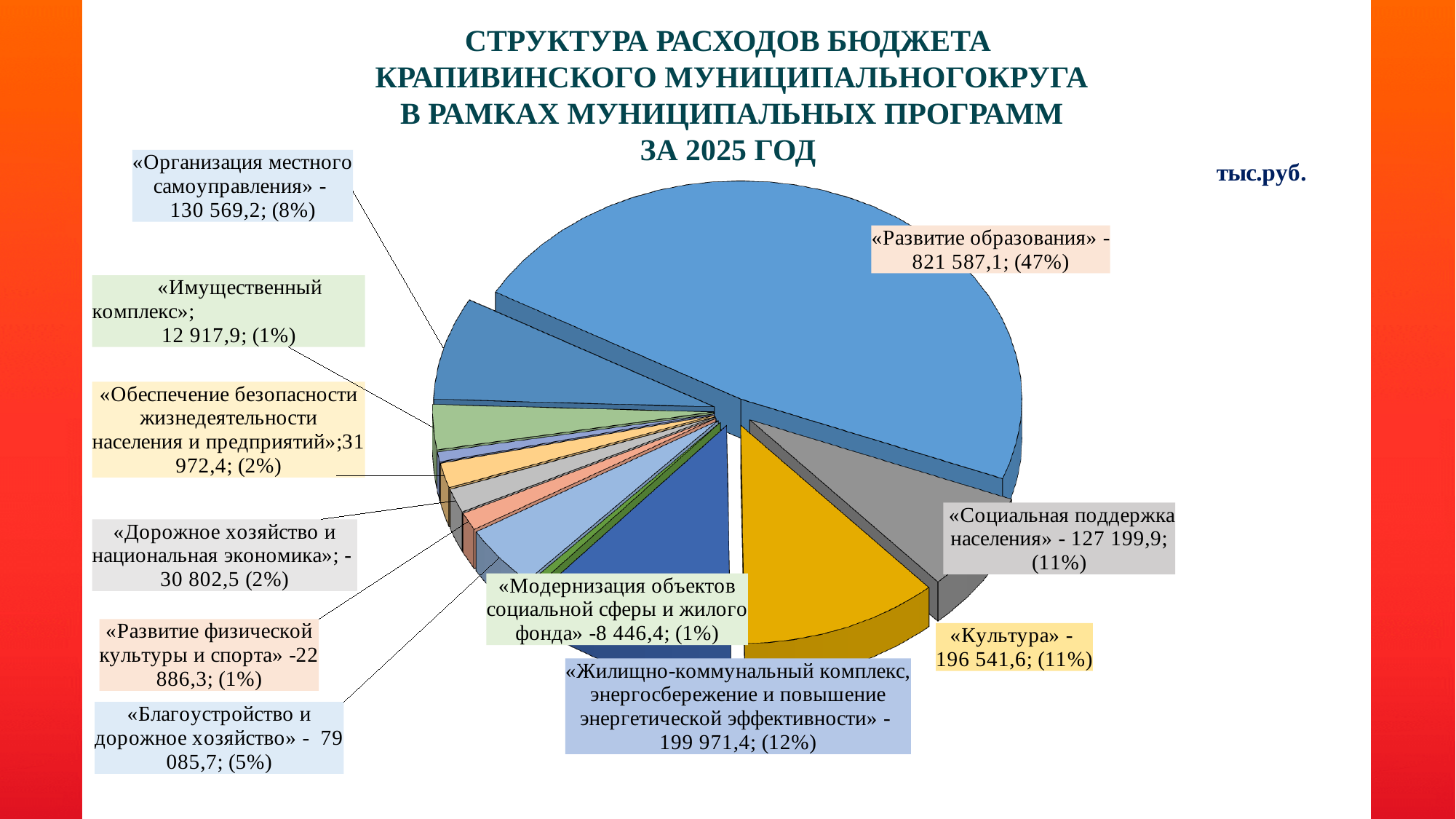
In what units are the values on the chart given? тыс.руб. What percentage share does «Развитие образования» have? 47% What kind of chart is shown on the slide? Pie chart Which is larger: the expenditure for «Имущественный комплекс» or for «Развитие физической культуры и спорта»? «Развитие физической культуры и спорта» What is the difference between the expenditure for «Жилищно-коммунальный комплекс, энергосбережение и повышение энергетической эффективности» and «Культура»? 3 429,8 Which is larger: the expenditure for «Благоустройство и дорожное хозяйство» or for «Дорожное хозяйство и национальная экономика»? «Благоустройство и дорожное хозяйство» What percentage share does «Социальная поддержка населения» have? 11% What is the expenditure value for «Обеспечение безопасности жизнедеятельности населения и предприятий»? 31 972,4 What is the expenditure value for «Культура»? 196 541,6 What is the expenditure value for «Организация местного самоуправления»? 130 569,2 Which programme has the smallest expenditure value in the pie chart? «Модернизация объектов социальной сферы и жилого фонда» Which programme has the largest share of budget expenditure in the pie chart? «Развитие образования»